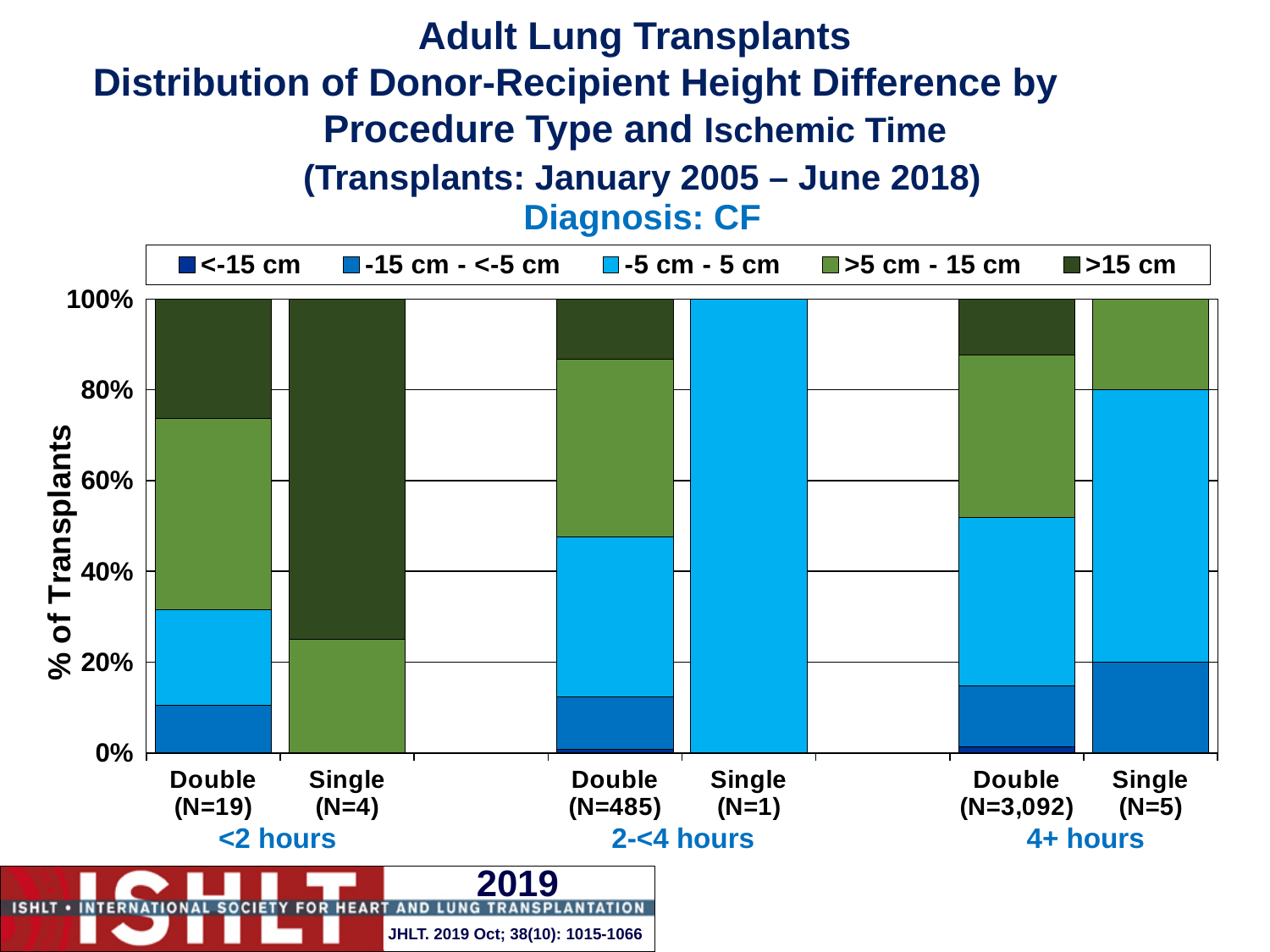
What is the value of the -15 cm - <-5 cm segment for the Single (N=5) bar in the 4+ hours group? 20% Is the -5 cm - 5 cm segment for the Double (N=3,092) bar in the 4+ hours group greater or less than 20%? greater Is the >15 cm segment for the Double (N=19) bar in the <2 hours group greater or less than 40%? less What is the value of the -5 cm - 5 cm segment for the Single (N=1) bar in the 2-<4 hours group? 100% How many series does the legend list? 5 Is the >15 cm segment for the Single (N=4) bar in the <2 hours group greater or less than 60%? greater What is the N for the Double bar in the 4+ hours group? N=3,092 How many bars are plotted in the chart? 6 What kind of chart is shown on the slide? Stacked bar chart What is the label on the y axis? % of Transplants What is the total of the stacked bar for Double (N=485)? 100% Which bar has the larger >15 cm segment: Double (N=19) or Single (N=4) in the <2 hours group? Single (N=4)